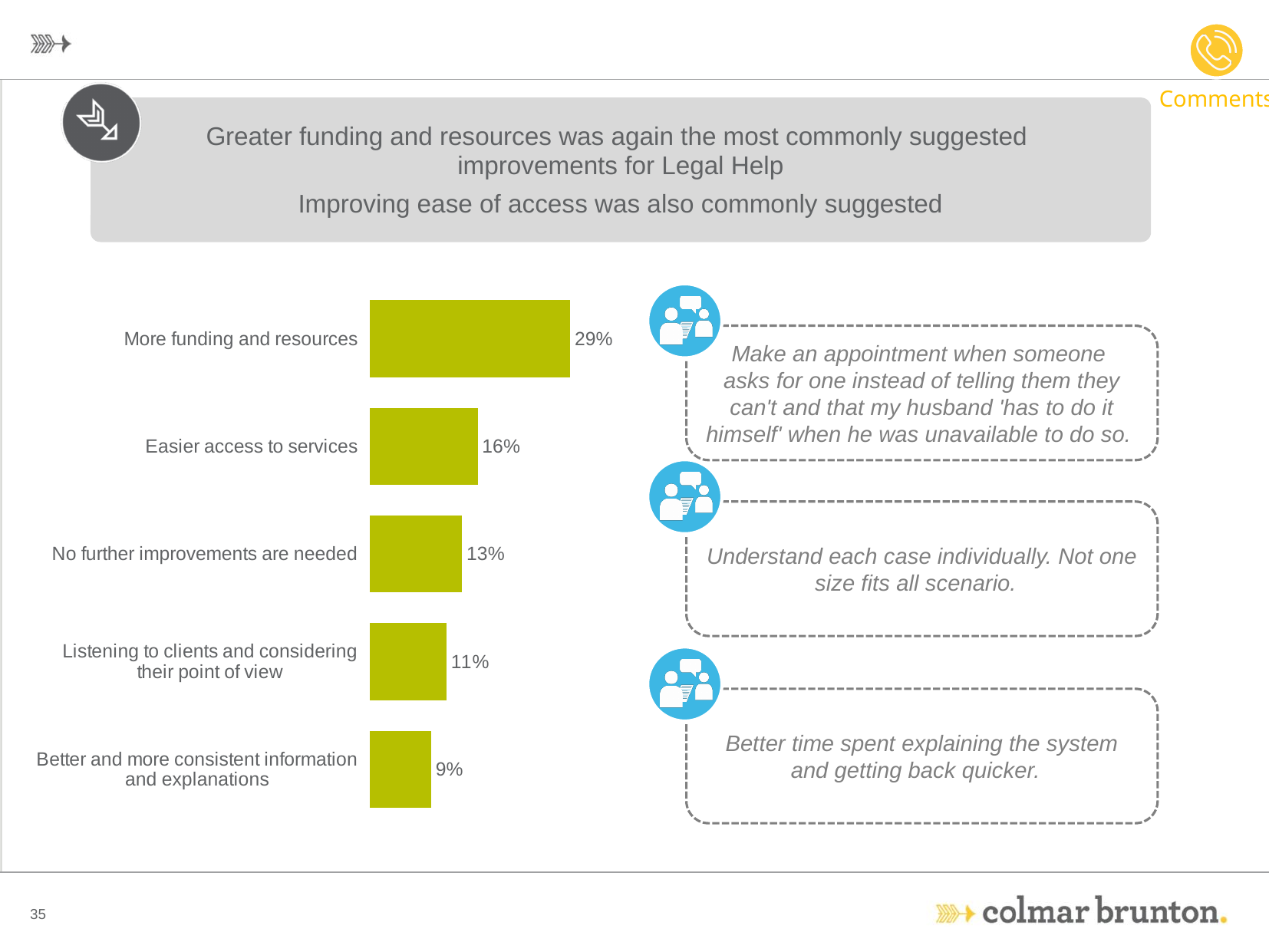
How many categories are shown in the chart? 5 What percentage is shown for "Easier access to services"? 16% Which category has the highest percentage? More funding and resources What kind of chart is shown on the slide? Bar chart What percentage is shown for "No further improvements are needed"? 13% Which category has the lowest percentage? Better and more consistent information and explanations What percentage is shown for "Better and more consistent information and explanations"? 9% What percentage is shown for "Listening to clients and considering their point of view"? 11% What is the difference in percentage points between "More funding and resources" and "Easier access to services"? 13 Which is larger: the value for "No further improvements are needed" or the value for "Listening to clients and considering their point of view"? No further improvements are needed What percentage is shown for "More funding and resources"? 29% What colour are the bars in the chart? Yellow-green